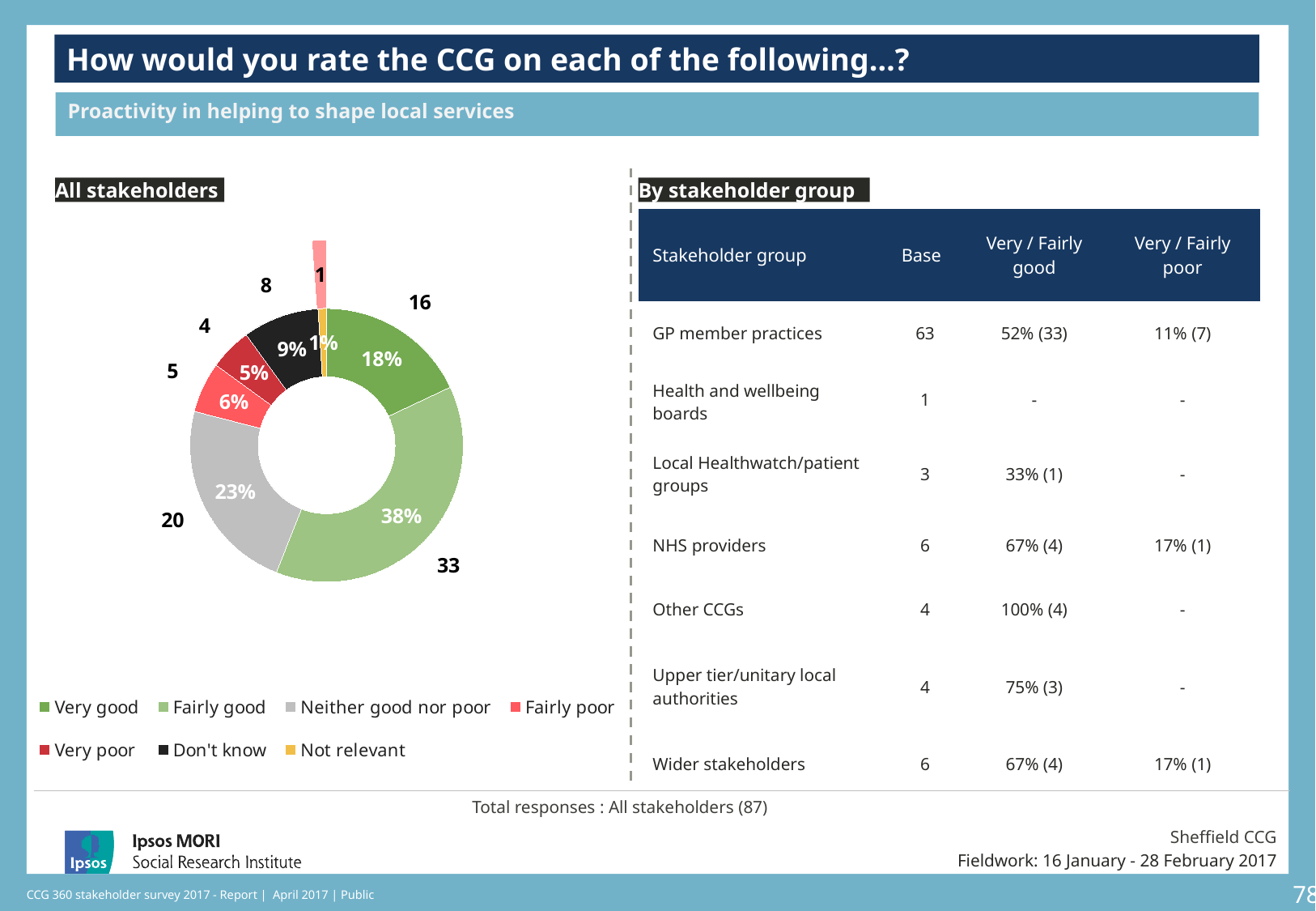
In the All stakeholders chart, which rating category has the smallest share? Not relevant In the All stakeholders chart, what percentage answered Neither good nor poor? 23% In the All stakeholders chart, which rating category has the largest share? Fairly good How many categories does the legend of the All stakeholders chart list? 7 In the All stakeholders chart, what percentage of respondents rated the CCG as Fairly good? 38% In the All stakeholders chart, what is the combined percentage for Very good and Fairly good? 56% What kind of chart is shown under "All stakeholders"? Doughnut (pie) chart In the All stakeholders chart, how many respondents answered Don't know? 8 In the All stakeholders chart, what percentage of respondents rated the CCG as Very good? 18% What colour is used for the Neither good nor poor segment in the All stakeholders chart? Grey In the All stakeholders chart, what is the difference in percentage points between Fairly good and Very good? 20 percentage points In the All stakeholders chart, which is larger: the share for Fairly poor or the share for Very poor? Fairly poor